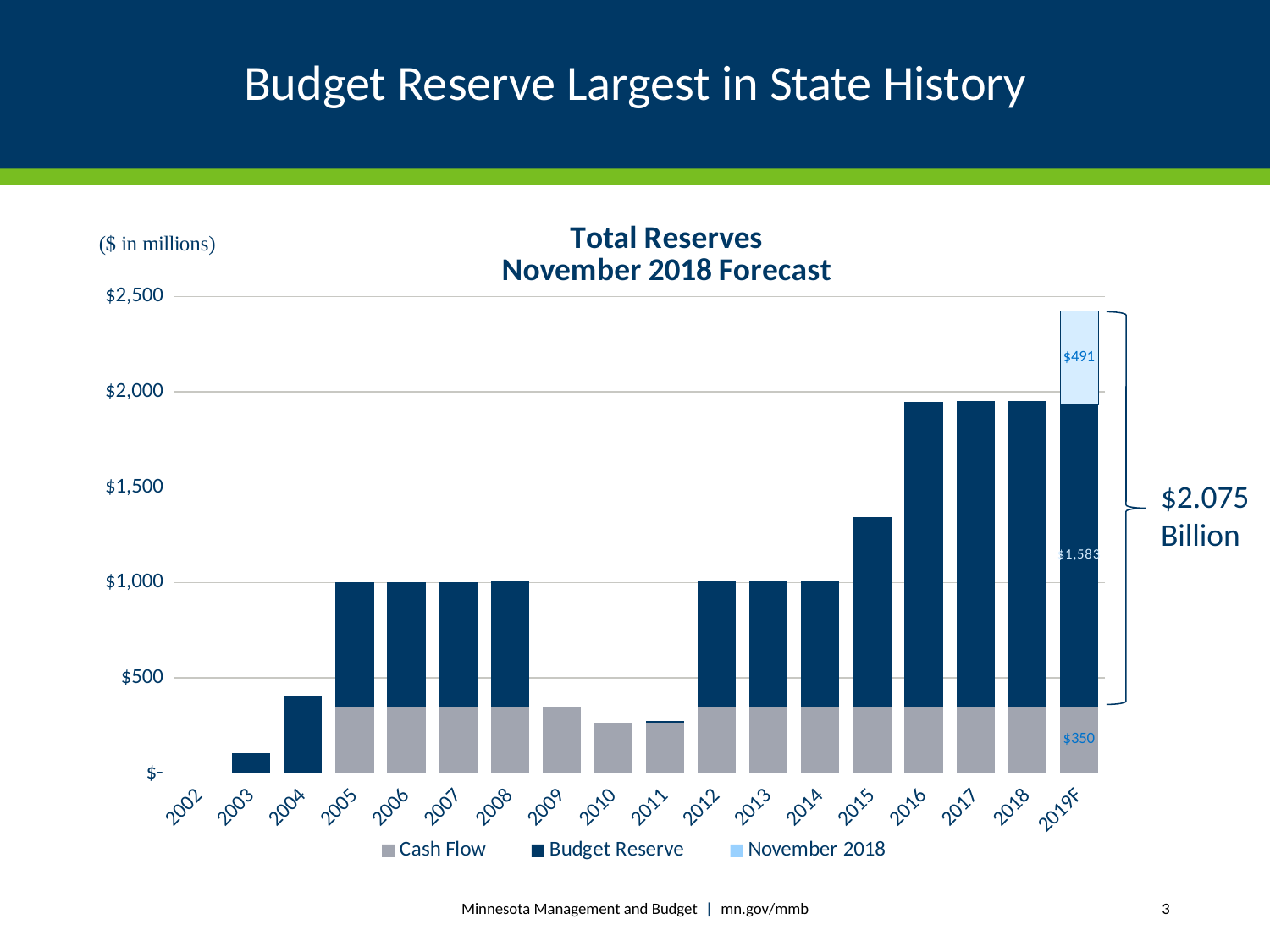
What is the Budget Reserve value for 2019F? $1,583 What kind of chart is shown? Stacked bar chart Which year has the tallest stacked bar? 2019F What is the Cash Flow value for 2019F? $350 How many years are shown on the x axis? 18 Is the total for 2016 greater or less than $1,500? greater What amount does the bracket annotation next to the 2019F bar show? $2.075 Billion How many series does the legend list? 3 Is the total for 2003 greater or less than $500? less What is the November 2018 value for 2019F? $491 In 2019F, how much larger is the Budget Reserve value than the Cash Flow value? $1,233 Which is larger, the total for 2014 or the total for 2015? 2015